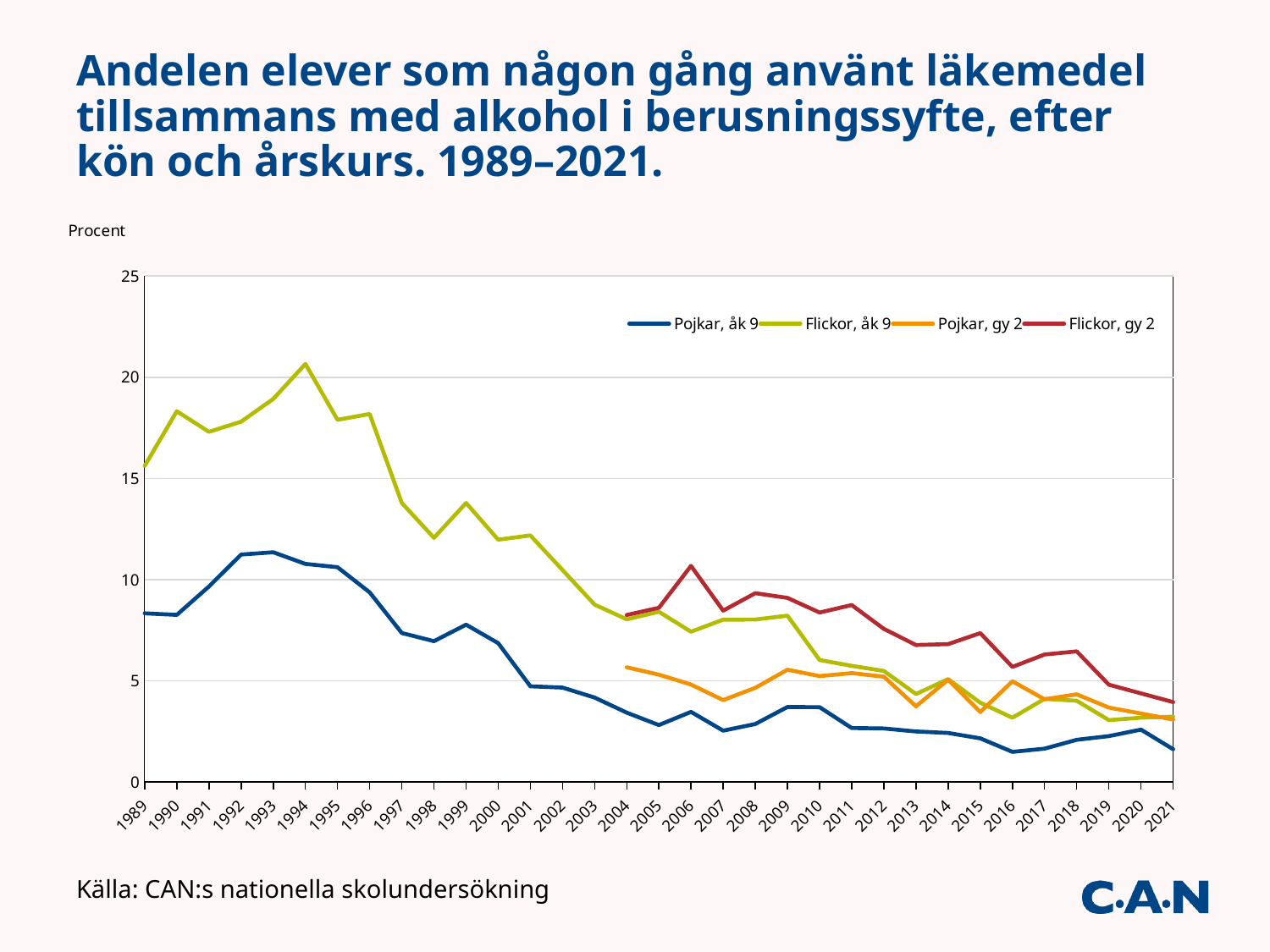
How many years are shown on the x axis? 33 Does the Flickor, åk 9 series rise or fall between 1994 and 2021? fall What kind of chart is shown on the slide? line chart In 1989, which series has the higher value: Flickor, åk 9 or Pojkar, åk 9? Flickor, åk 9 Is the value for Pojkar, åk 9 in 2021 greater or less than 5? less Which series has the lowest value in 2021? Pojkar, åk 9 What are the series names listed in the legend? Pojkar, åk 9; Flickor, åk 9; Pojkar, gy 2; Flickor, gy 2 Is the value for Flickor, gy 2 in 2006 greater or less than 10? greater Is the value for Flickor, åk 9 in 1994 greater or less than 20? greater How many series does the legend list? 4 In which year does the Flickor, åk 9 series reach its highest value? 1994